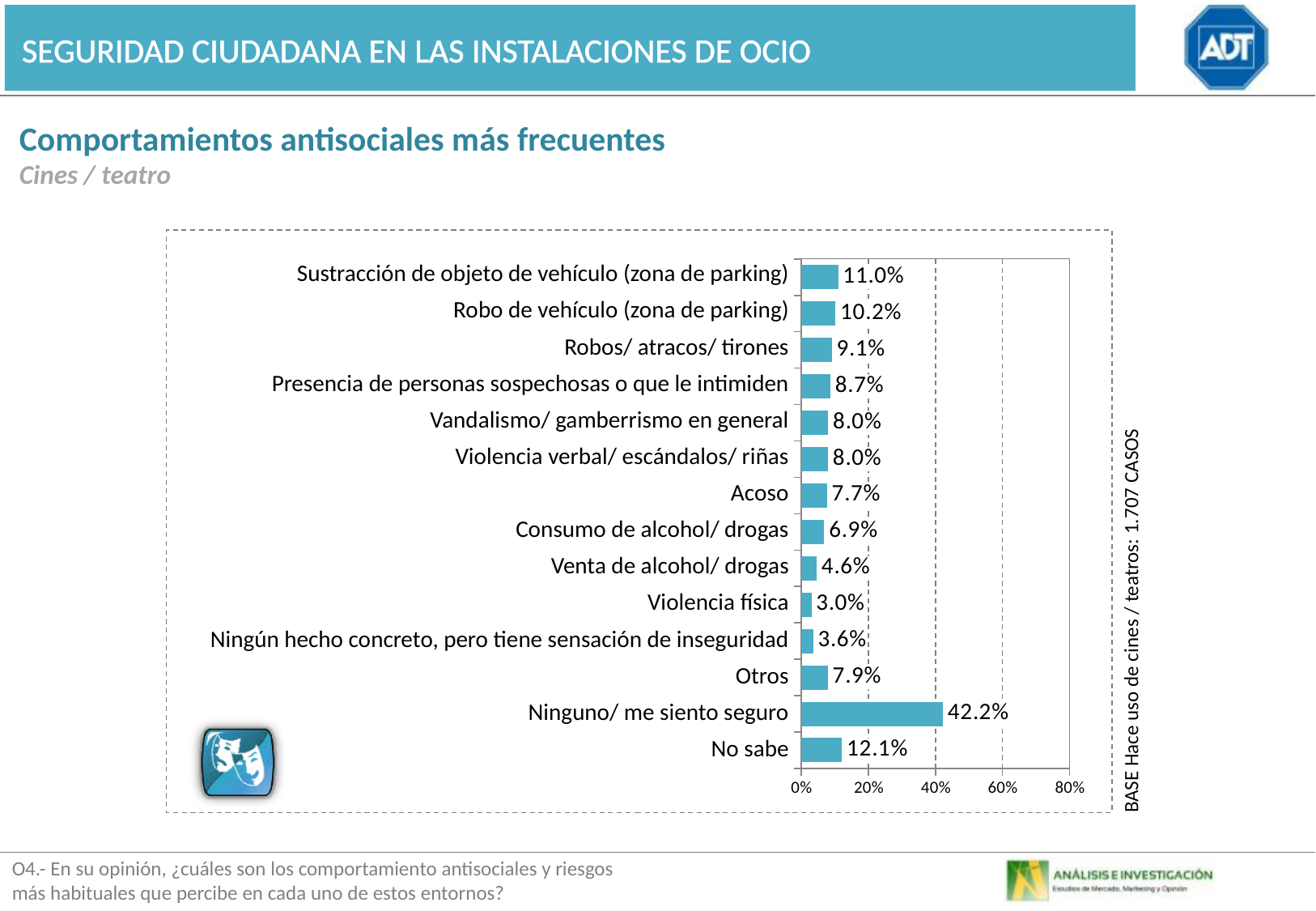
What is the base stated beside the chart? Hace uso de cines / teatros: 1.707 CASOS What is the value for "No sabe"? 12.1% What is the value for "Venta de alcohol/ drogas"? 4.6% What is the value for "Ninguno/ me siento seguro"? 42.2% What kind of chart is shown on the slide? Bar chart What is the difference between "Ninguno/ me siento seguro" and "No sabe"? 30.1% Which category has the highest value? Ninguno/ me siento seguro How many categories are shown in the chart? 14 Which is larger, "Acoso" or "Consumo de alcohol/ drogas"? Acoso What is the difference between "Sustracción de objeto de vehículo (zona de parking)" and "Robo de vehículo (zona de parking)"? 0.8% What is the value for "Sustracción de objeto de vehículo (zona de parking)"? 11.0% Which category has the lowest value? Violencia física